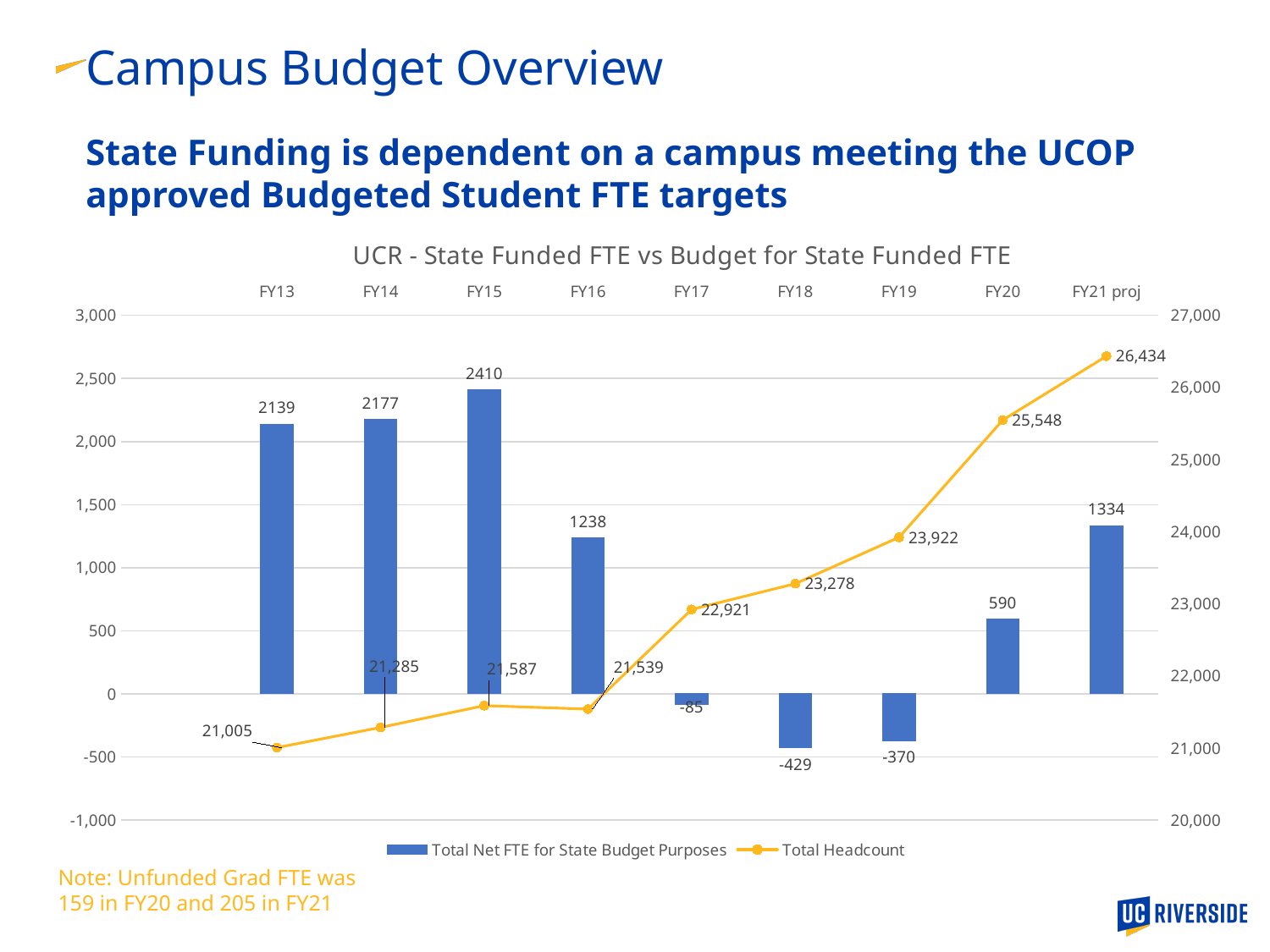
Which fiscal year has the highest Total Net FTE for State Budget Purposes? FY15 Which is larger, the Total Net FTE for State Budget Purposes in FY14 or in FY13? FY14 How many fiscal years are shown on the x axis? 9 What is the difference in Total Headcount between FY21 proj and FY20? 886 How many series does the legend list? 2 What is the title of the chart? UCR - State Funded FTE vs Budget for State Funded FTE Which fiscal year has the lowest Total Net FTE for State Budget Purposes? FY18 Does the Total Headcount rise or fall from FY16 to FY21 proj? Rise What kind of chart is this? Combined bar and line chart What is the Total Headcount in FY21 proj? 26,434 What is the Total Net FTE for State Budget Purposes in FY18? -429 What is the Total Net FTE for State Budget Purposes in FY15? 2410